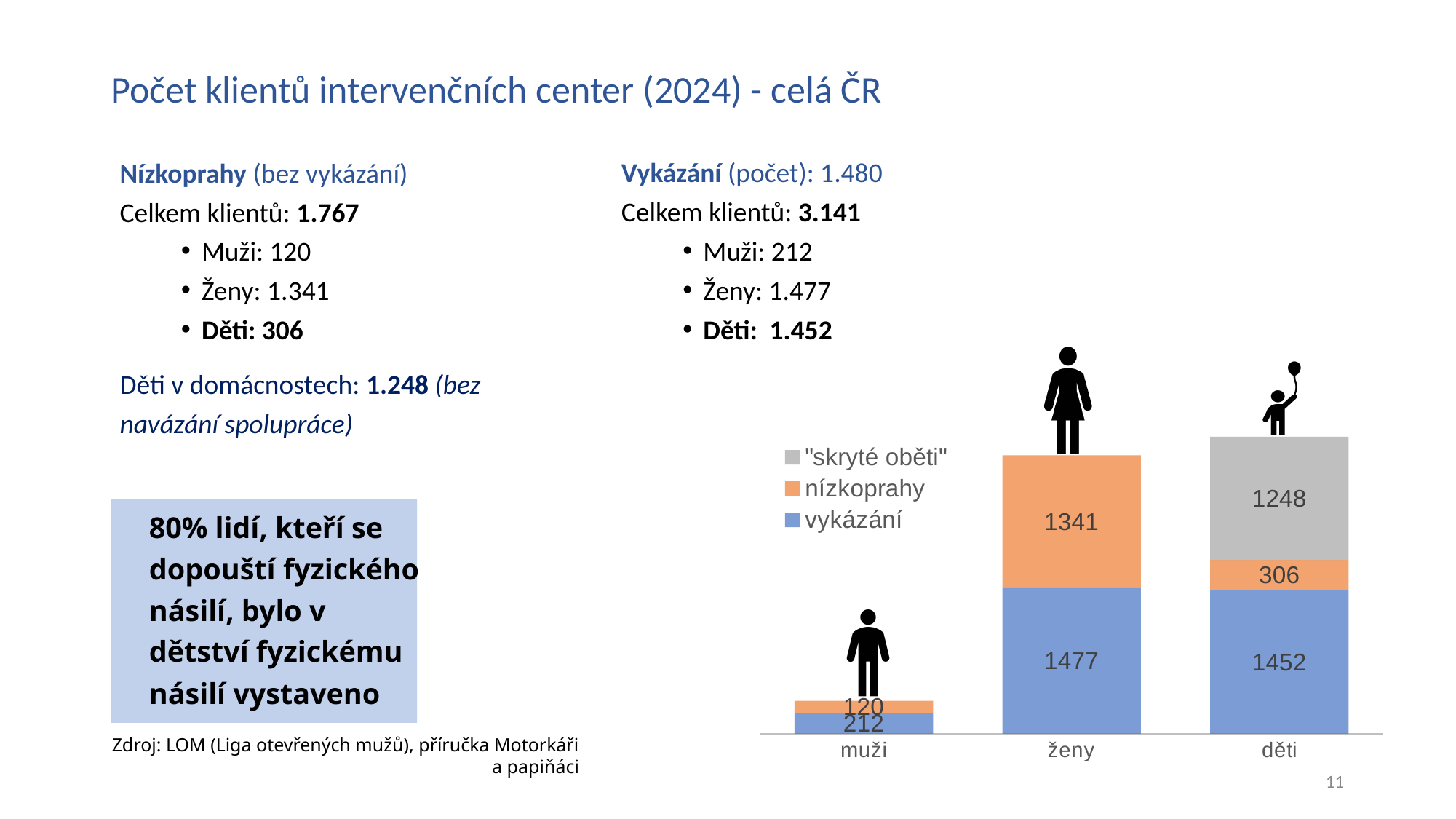
Which category has the lowest vykázání value in the chart? muži What is the nízkoprahy value for děti in the chart? 306 Which series in the chart is shown in grey? "skryté oběti" How many categories are shown on the x axis of the chart? 3 What is the total of the stacked bar for děti in the chart? 3006 What is the vykázání value for muži in the chart? 212 What is the vykázání value for ženy in the chart? 1477 What is the difference between the vykázání values for ženy and děti in the chart? 25 How many series does the chart legend list? 3 What kind of chart is shown on the slide? stacked bar chart What is the "skryté oběti" value for děti in the chart? 1248 Which category has the highest nízkoprahy value in the chart? ženy